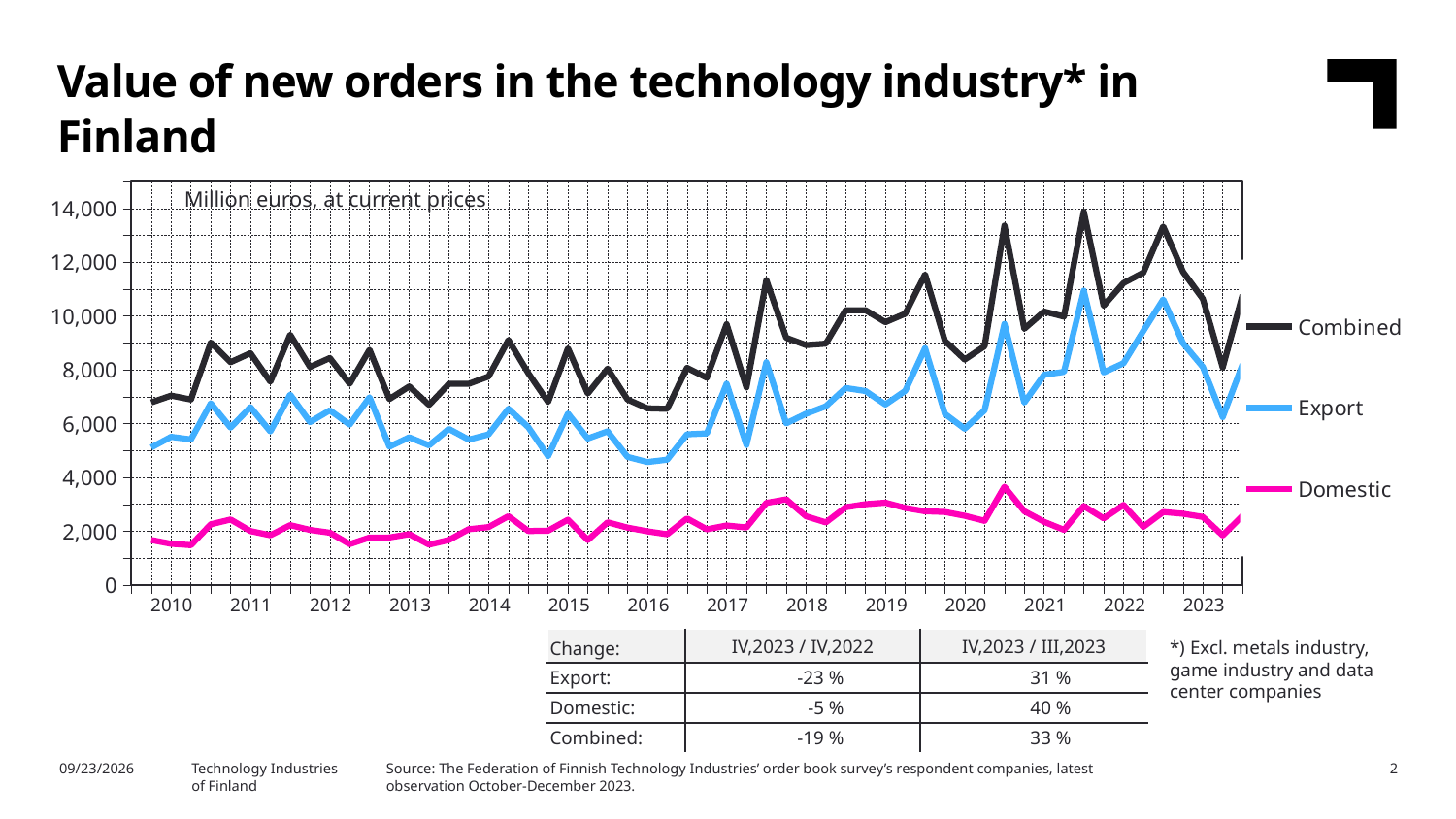
What type of chart is shown on the slide? line chart Overall, does the Combined series rise or fall from 2010 to 2023? rise Which series has the lowest values throughout the chart? Domestic How many series does the chart's legend list? 3 Which series has the highest values throughout the chart? Combined How many year labels are shown on the x axis? 14 Is the highest value reached by the Combined series greater or less than 12,000? greater Is the highest value reached by the Export series greater or less than 12,000? less What unit label is printed inside the chart area? Million euros, at current prices What are the three series named in the chart legend? Combined, Export, Domestic Is the highest value reached by the Domestic series greater or less than 4,000? less Which series is larger in 2021, Export or Domestic? Export